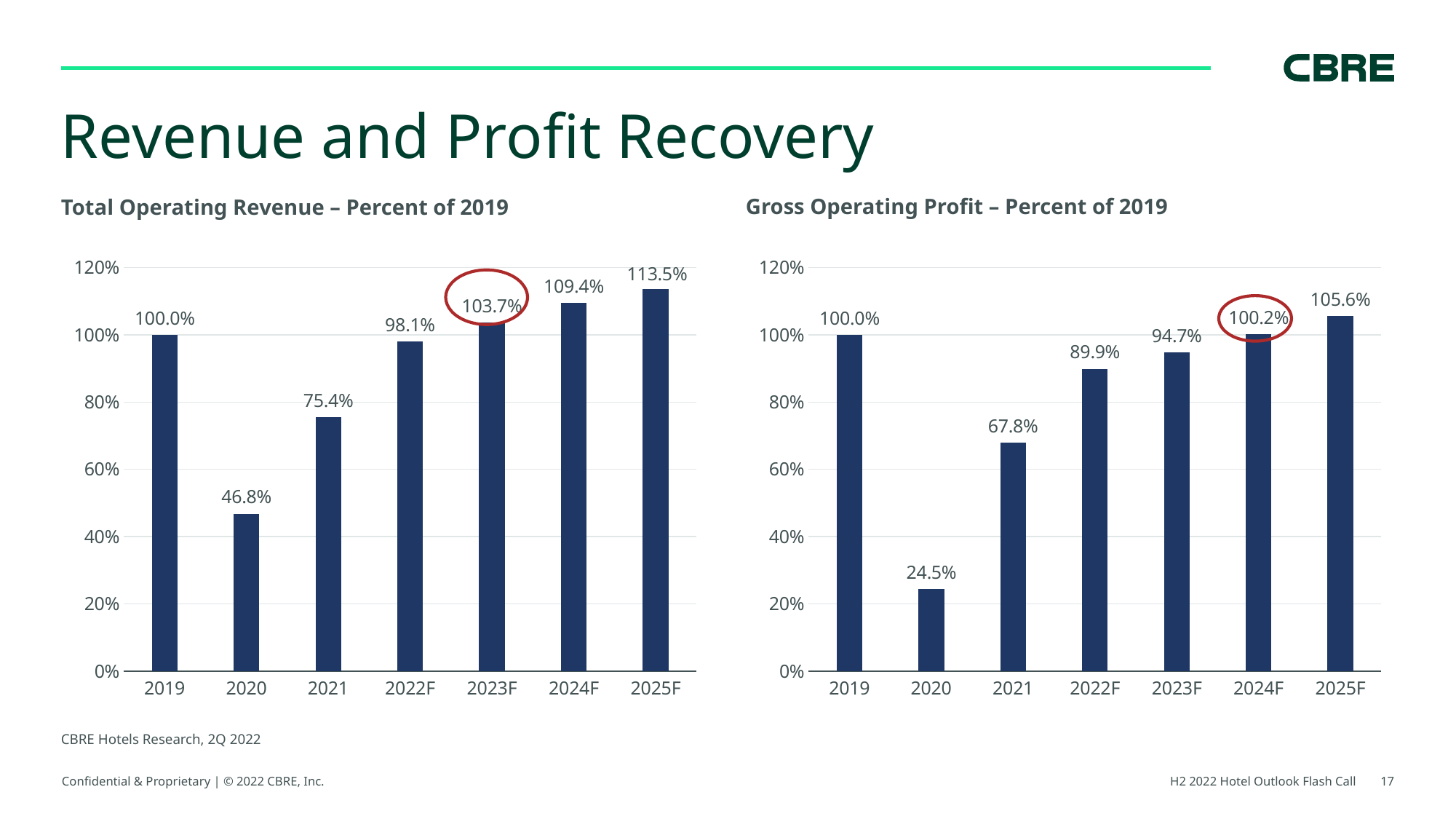
What kind of chart is the 'Total Operating Revenue – Percent of 2019' chart? bar chart In the 'Total Operating Revenue – Percent of 2019' chart, is the value for 2021 greater or less than 80%? less In the 'Total Operating Revenue – Percent of 2019' chart, what is the value for 2020? 46.8% In the 'Gross Operating Profit – Percent of 2019' chart, what is the difference between the 2021 value and the 2020 value? 43.3% In the 'Total Operating Revenue – Percent of 2019' chart, which year has the highest value? 2025F In the 'Gross Operating Profit – Percent of 2019' chart, what is the value for 2023F? 94.7% In the 'Gross Operating Profit – Percent of 2019' chart, which is larger, the value for 2022F or the value for 2023F? 2023F In the 'Total Operating Revenue – Percent of 2019' chart, what is the difference between the 2025F value and the 2019 value? 13.5% How many years are shown on the x axis of the 'Gross Operating Profit – Percent of 2019' chart? 7 In the 'Gross Operating Profit – Percent of 2019' chart, which year's data label is circled in red? 2024F In the 'Gross Operating Profit – Percent of 2019' chart, which year has the lowest value? 2020 In the 'Gross Operating Profit – Percent of 2019' chart, do the values rise or fall from 2020 to 2025F? rise